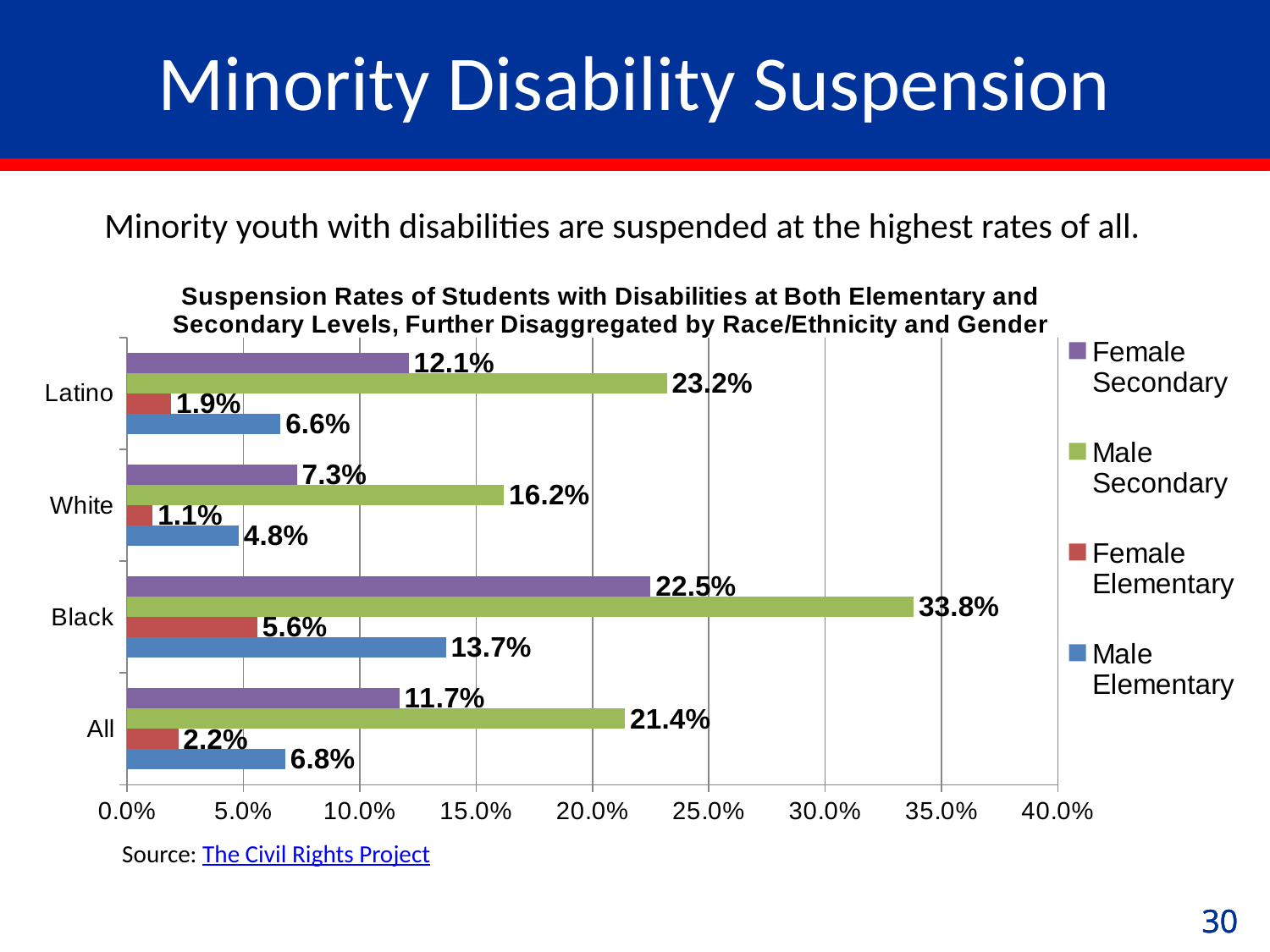
What kind of chart is shown on the slide? Bar chart What is the Male Elementary suspension rate for Latino students? 6.6% What is the Female Elementary suspension rate for White students? 1.1% What is the difference between the Male Secondary and Female Secondary suspension rates for Latino students? 11.1% Which race/ethnicity category has the lowest Male Secondary suspension rate? White What is the Male Secondary suspension rate for Black students? 33.8% Which is larger: the Male Elementary rate for Black students or the Male Elementary rate for All students? Male Elementary rate for Black students Is the Male Secondary suspension rate for Black students greater or less than 30.0%? greater How many series does the legend list? 4 How many race/ethnicity categories are shown on the chart? 4 Which colour represents the Female Elementary series in the chart? Red Which race/ethnicity category has the highest Female Secondary suspension rate? Black